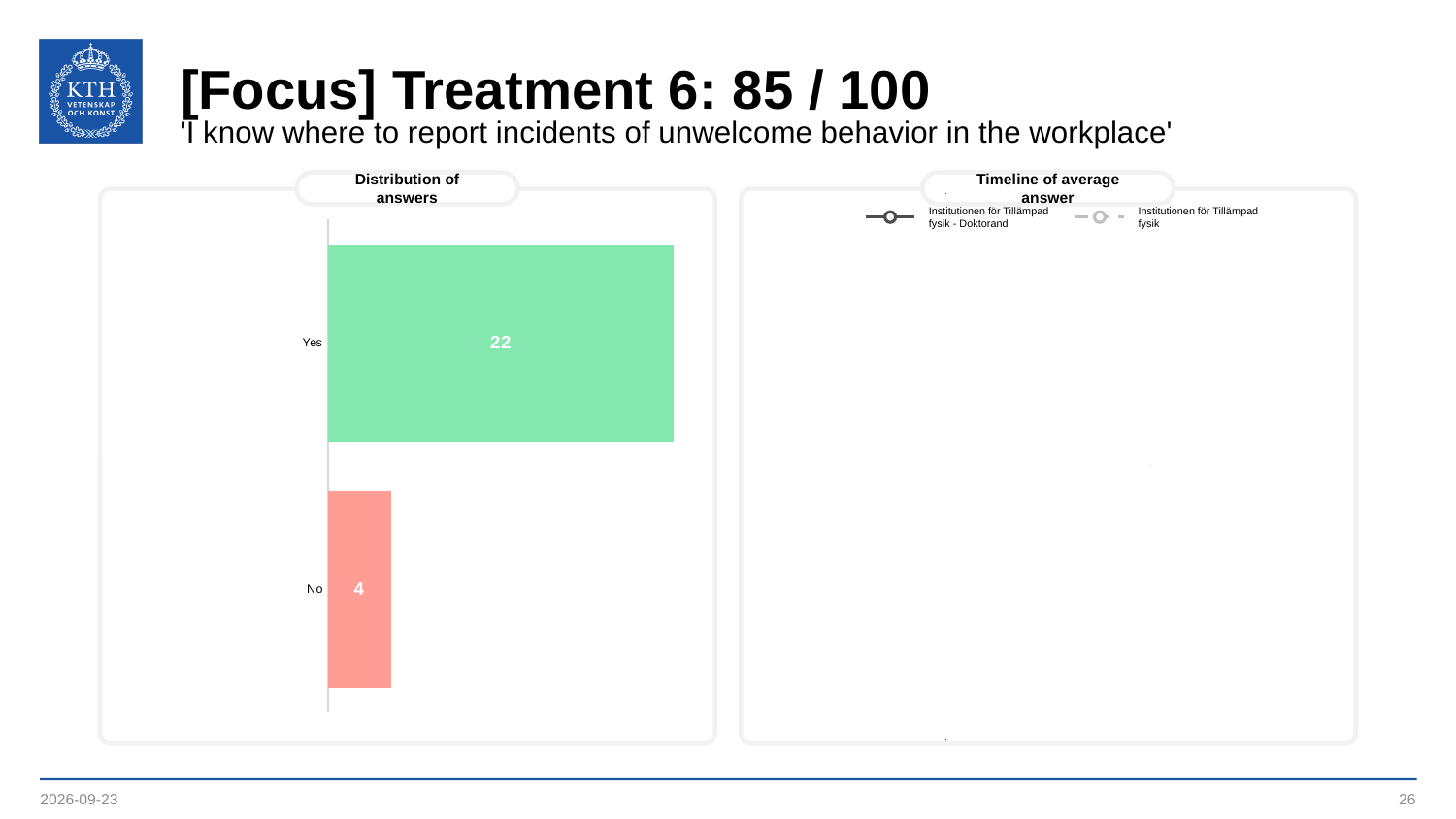
In the 'Distribution of answers' chart, what is the difference between the Yes and No values? 18 What kind of chart is the 'Distribution of answers' chart? bar chart In the 'Distribution of answers' chart, which is larger, Yes or No? Yes In the 'Distribution of answers' chart, what is the value for Yes? 22 In the 'Distribution of answers' chart, what is the value for No? 4 In the 'Distribution of answers' chart, which category has the lowest value? No How many series does the legend of the 'Timeline of average answer' chart list? 2 What is the title of the chart on the right side of the slide? Timeline of average answer In the 'Distribution of answers' chart, what colour is the Yes bar? green In the 'Distribution of answers' chart, what is the total of the Yes and No values? 26 How many categories are shown in the 'Distribution of answers' chart? 2 In the 'Distribution of answers' chart, which category has the highest value? Yes